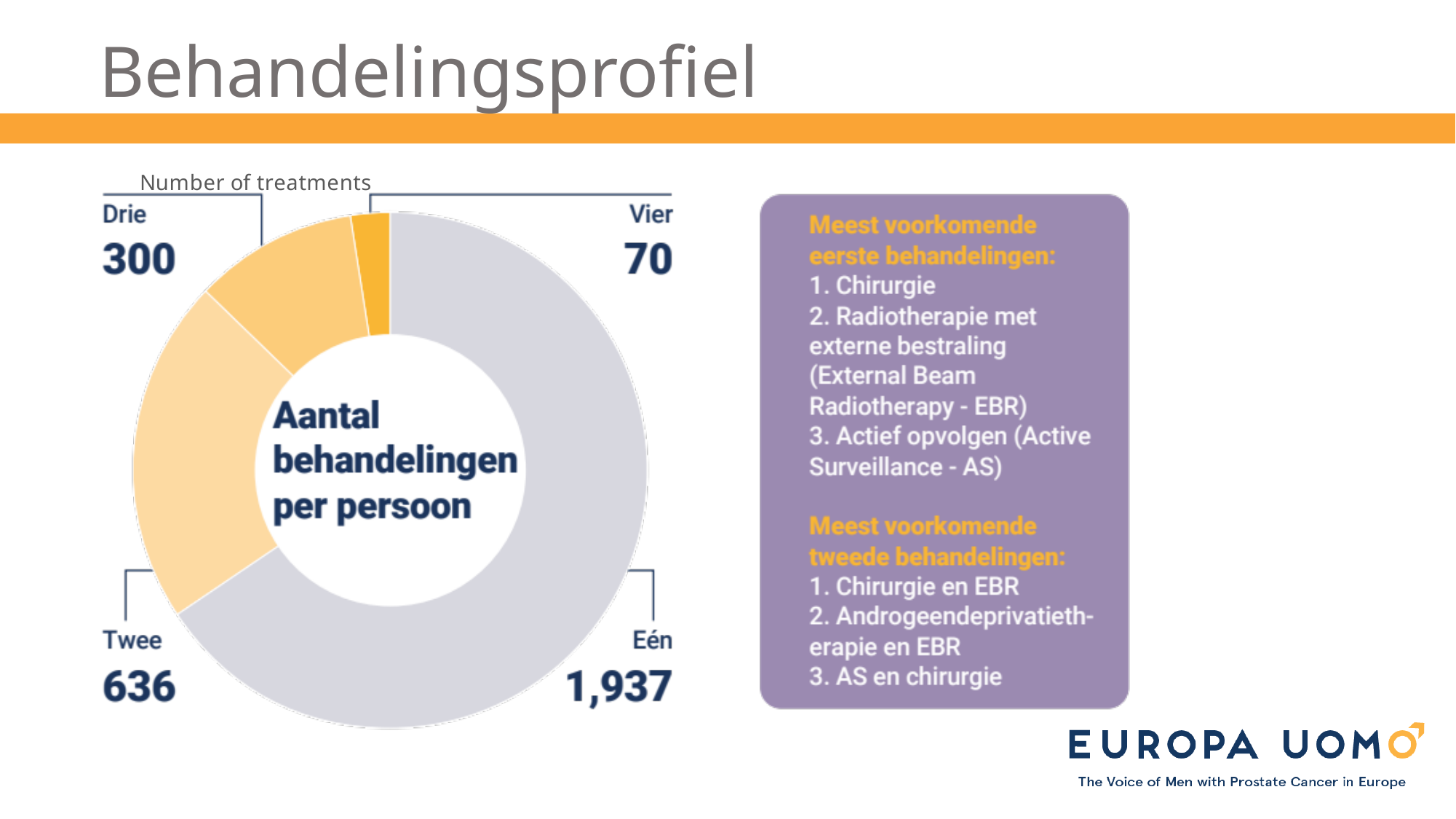
Which category has the largest slice of the chart? Eén How many categories does the chart show? 4 What is the difference between the values for Drie and Vier? 230 How many people had one treatment (Eén)? 1,937 What is the value for Twee (two treatments)? 636 What kind of chart is shown on the slide? Pie chart (donut) Which category has the smallest slice of the chart? Vier What is the difference between the values for Eén and Twee? 1,301 What is the text in the centre of the donut chart? Aantal behandelingen per persoon Which is larger, the value for Twee or the value for Drie? Twee What is the value for Vier (four treatments)? 70 What is the value for Drie (three treatments)? 300